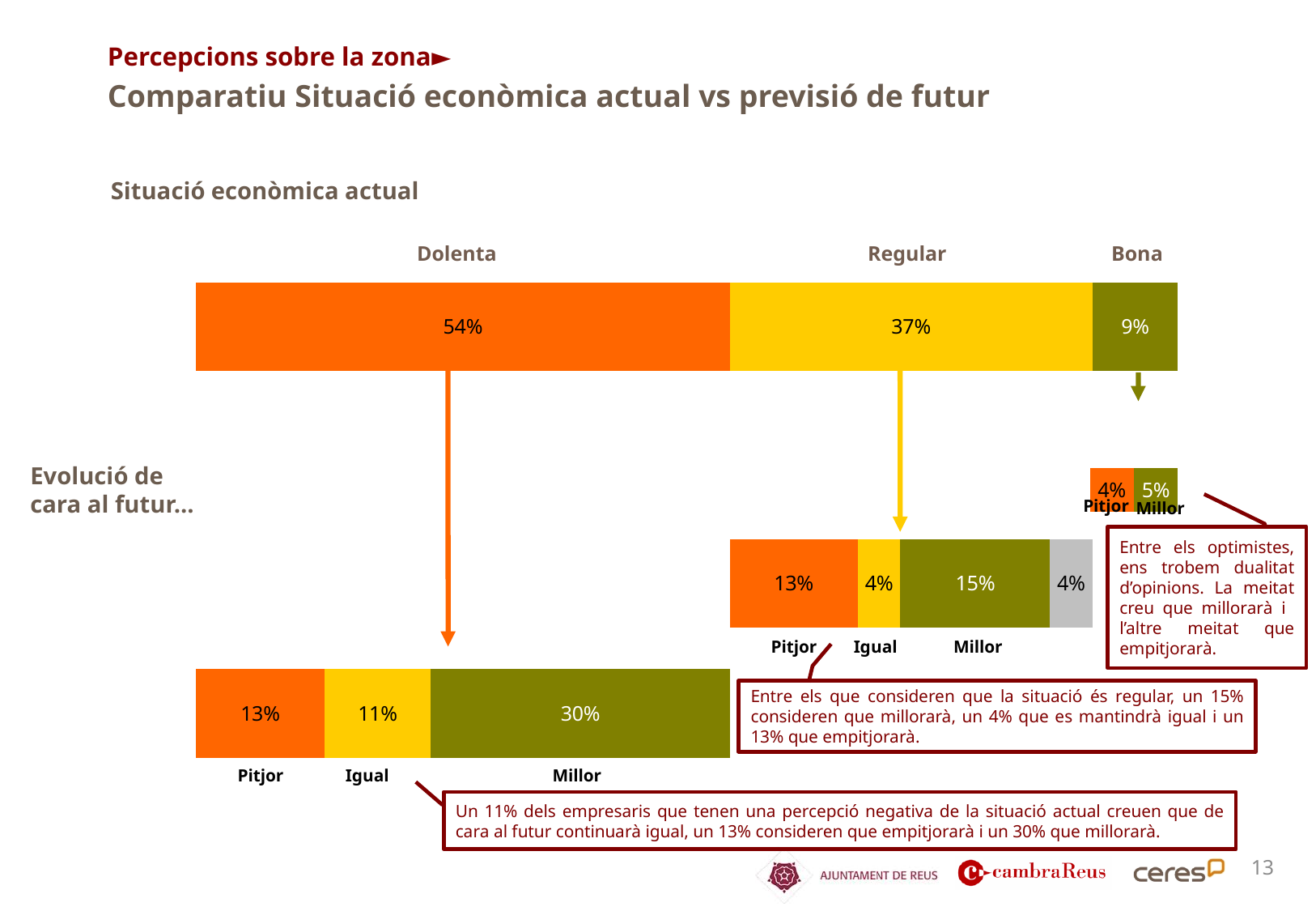
In the small top-right bar (future evolution for those who see the situation as Bona), what percentage is shown for Pitjor? 4% In the 'Situació econòmica actual' bar, what is the difference between the Dolenta and Regular percentages? 17% In the 'Situació econòmica actual' bar, which category has the lowest percentage? Bona In the middle-right bar (future evolution for those who see the situation as Regular), which is larger, Pitjor or Igual? Pitjor In the 'Situació econòmica actual' bar, which category has the highest percentage? Dolenta In the bottom-left bar (future evolution for those who see the situation as Dolenta), what percentage is shown for Millor? 30% In the middle-right bar (future evolution for those who see the situation as Regular), what percentage is shown for Millor? 15% In the bottom-left bar (future evolution for those who see the situation as Dolenta), what percentage is shown for Igual? 11% What kind of chart is used to show 'Situació econòmica actual'? Stacked bar chart In the 'Situació econòmica actual' bar, what percentage is shown for Dolenta? 54% In the 'Situació econòmica actual' bar, what percentage is shown for Bona? 9% In the 'Situació econòmica actual' bar, what percentage is shown for Regular? 37%